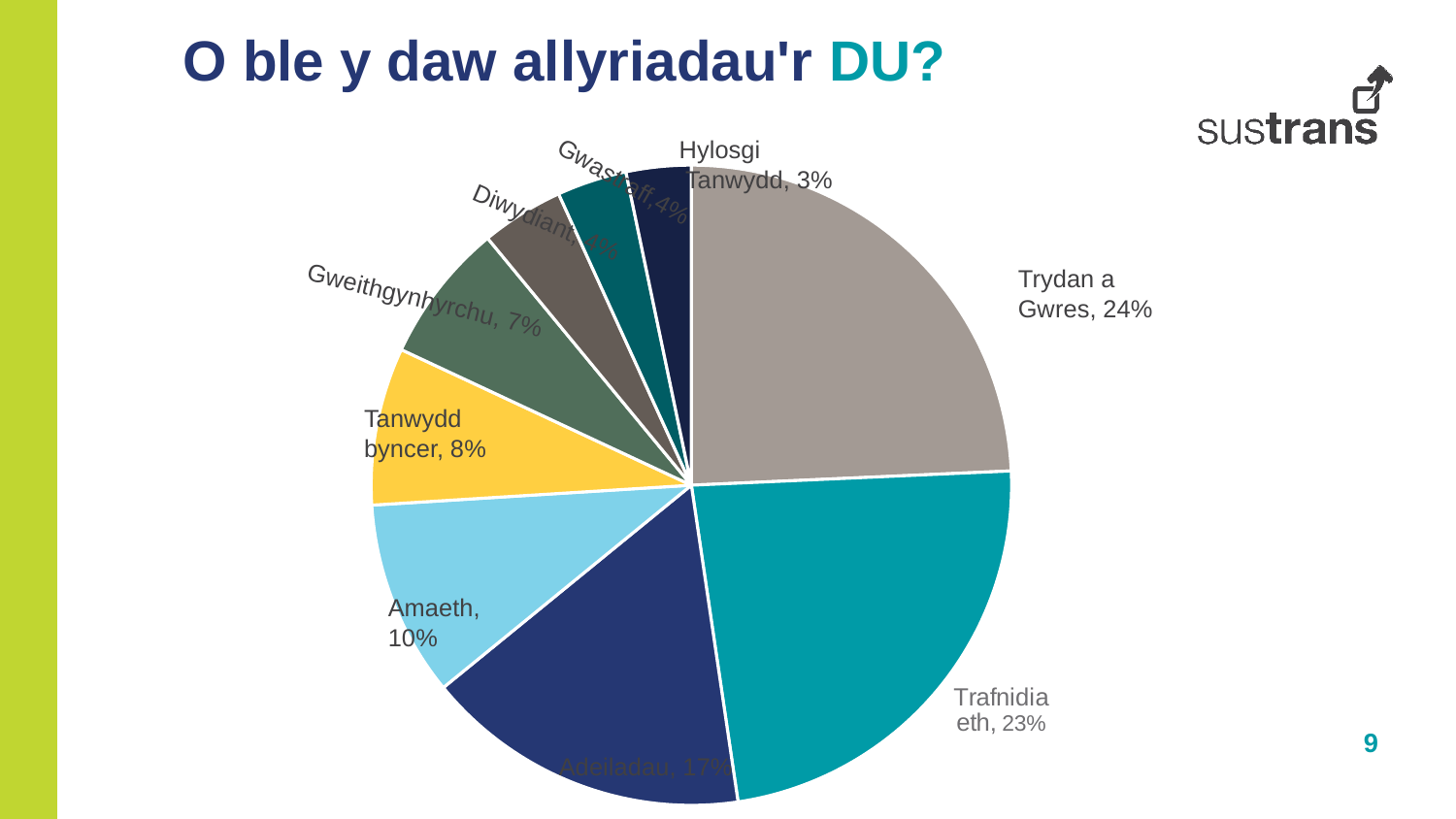
What is the value for Tanwydd byncer? 8% What kind of chart is shown on the slide? pie chart What is the value for Trafnidiaeth? 23% Which category has the smallest slice of the pie? Hylosgi Tanwydd What is the value for Gweithgynhyrchu? 7% What is the value for Adeiladau? 17% Which is larger, the value for Amaeth or the value for Tanwydd byncer? Amaeth What share of the pie does Trydan a Gwres have? 24% How many slices does the pie chart have? 9 What is the value for Amaeth? 10% Which category has the largest slice of the pie? Trydan a Gwres What is the difference between the values for Trydan a Gwres and Trafnidiaeth? 1%